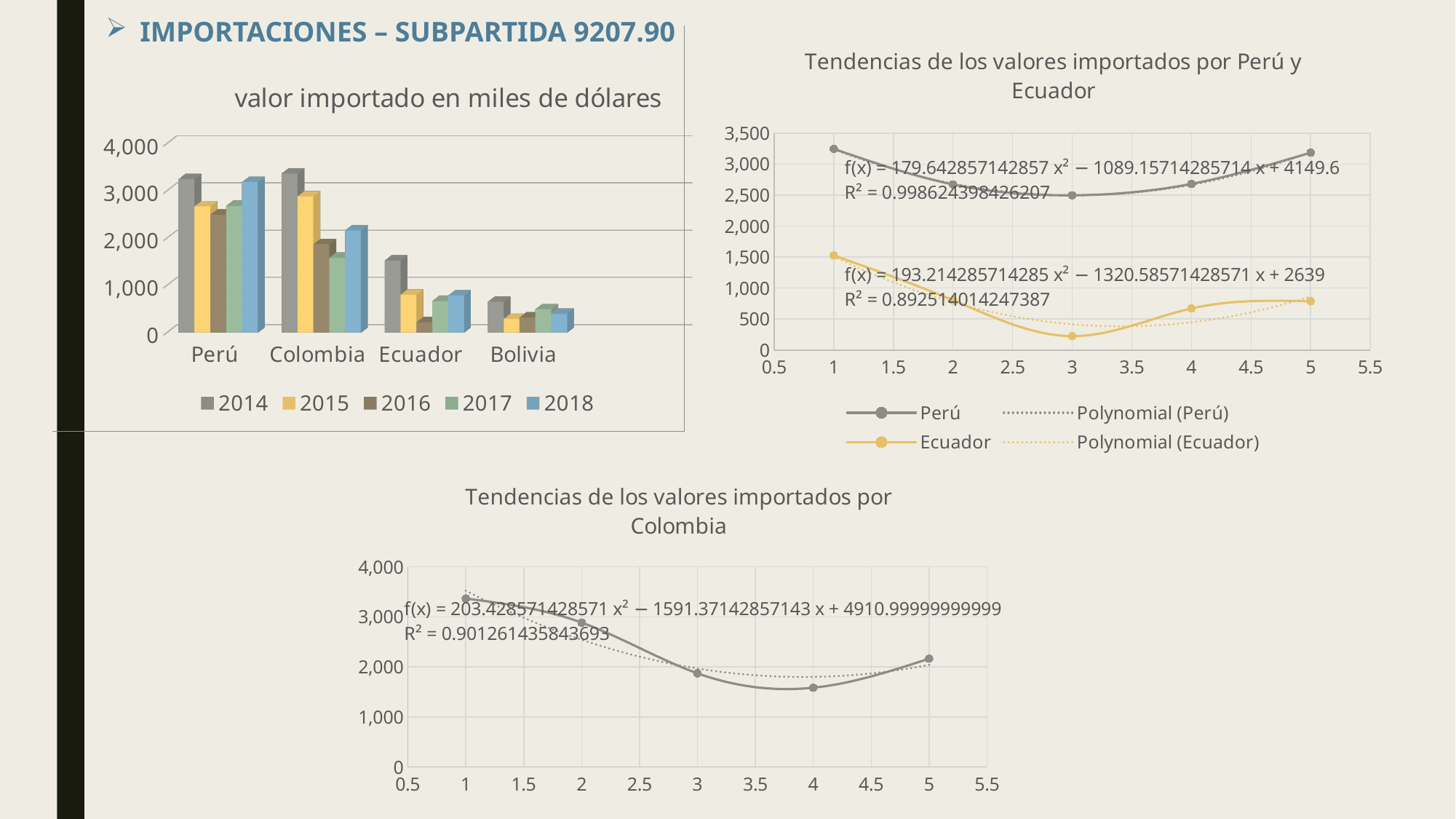
In the chart titled "Tendencias de los valores importados por Colombia", at which x value is the plotted point lowest? 4 How many series does the legend list in the chart titled "valor importado en miles de dólares"? 5 In the chart titled "valor importado en miles de dólares", which country has the lowest 2014 value? Bolivia In the chart titled "Tendencias de los valores importados por Perú y Ecuador", what is the R² value shown for the Perú trendline? 0.998624398426207 What kind of chart is the chart titled "valor importado en miles de dólares"? bar chart In the chart titled "Tendencias de los valores importados por Colombia", is the value at x = 1 greater or less than 3,000? greater How many countries are shown on the x axis of the chart titled "valor importado en miles de dólares"? 4 In the chart titled "valor importado en miles de dólares", is the 2014 value for Bolivia greater or less than 1,000? less In the chart titled "Tendencias de los valores importados por Perú y Ecuador", is the Ecuador value at x = 3 greater or less than 500? less In the chart titled "valor importado en miles de dólares", which is larger for 2018: Perú or Ecuador? Perú How many entries does the legend list in the chart titled "Tendencias de los valores importados por Perú y Ecuador"? 4